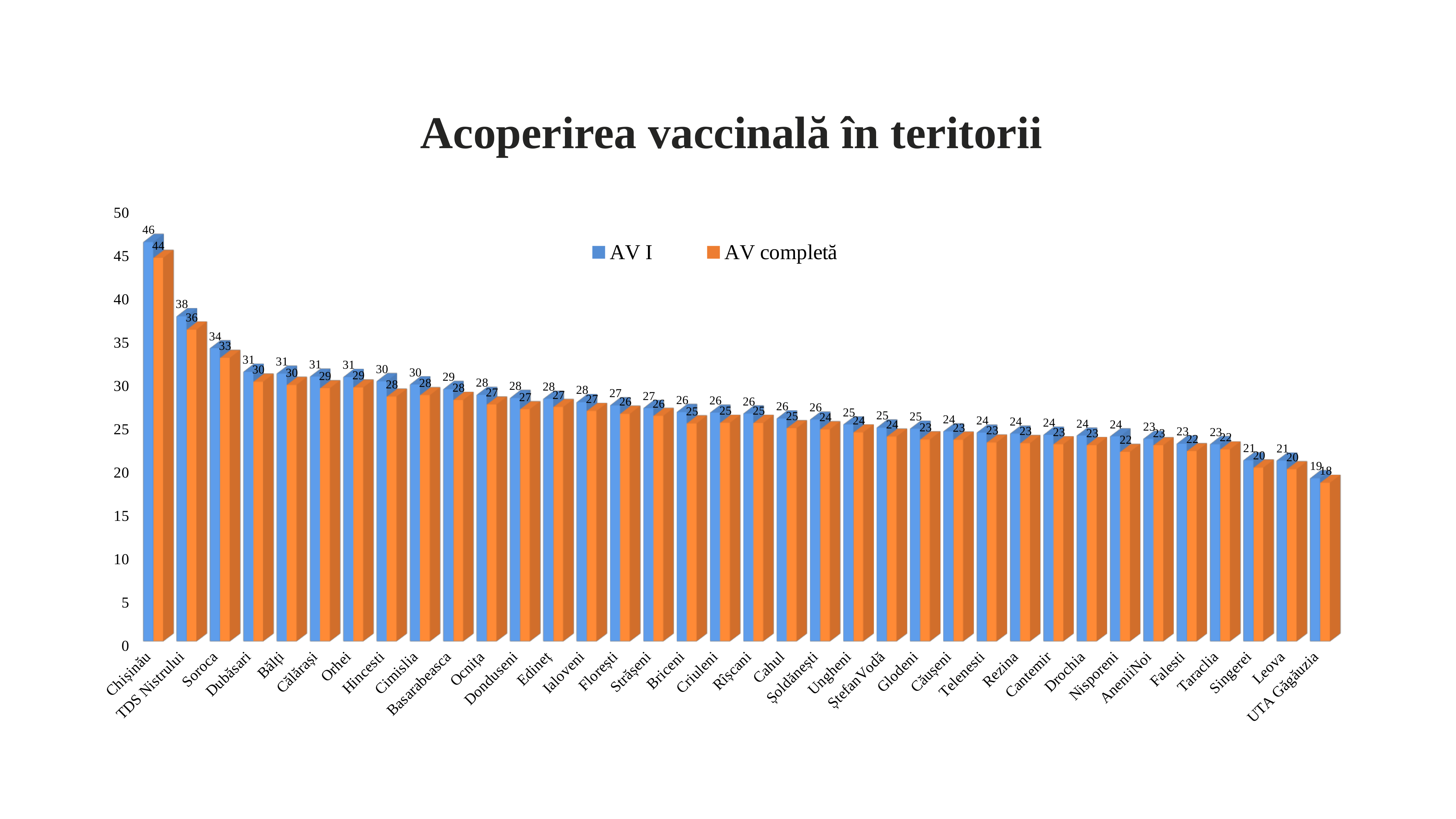
Do the AV I values rise or fall from left to right along the x axis? fall What kind of chart is shown on the slide? bar chart What is the AV I value for Chișinău? 46 Which is larger, the AV I value for Soroca or the AV I value for Dubăsari? Soroca How many series does the legend list? 2 Is the AV I value for TDS Nistrului greater or less than 35? greater What is the AV completă value for TDS Nistrului? 36 What is the AV completă value for Soroca? 33 Which territory has the highest AV I value? Chișinău Which territory has the lowest AV completă value? UTA Găgăuzia What is the difference between the AV I and AV completă values for Chișinău? 2 How many territories are shown on the x axis? 36